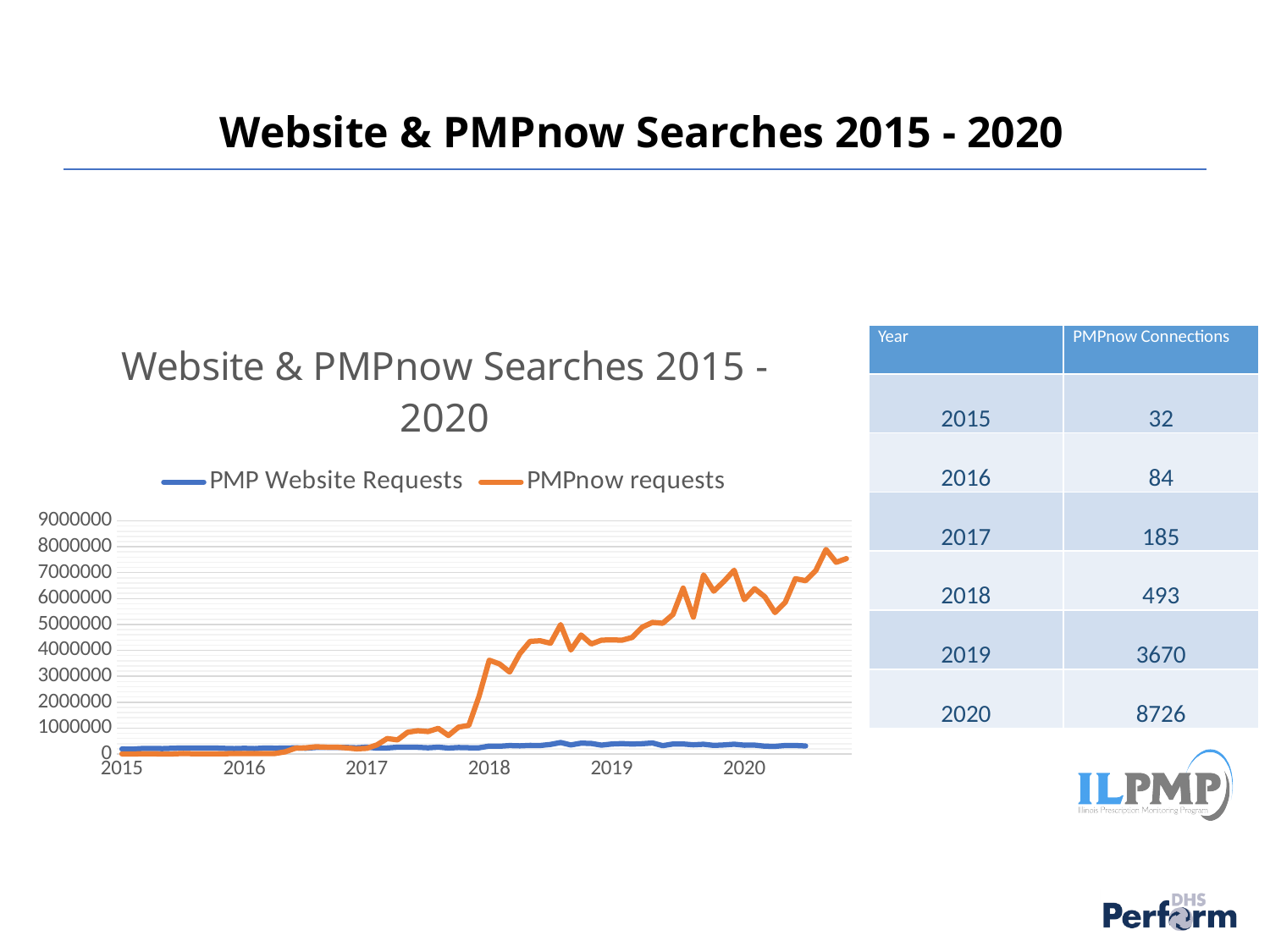
Which series has the higher values in 2020, PMP Website Requests or PMPnow requests? PMPnow requests Is the value for PMPnow requests at the end of 2020 greater or less than 7000000? greater Is the value for PMP Website Requests in 2019 greater or less than 1000000? less Is the value for PMPnow requests at the start of 2018 greater or less than 2000000? greater What is the highest value shown on the chart's y axis? 9000000 Do the PMPnow requests values generally rise or fall from 2015 to 2020? rise How many year labels are shown along the x axis of the chart? 6 How many series does the chart's legend list? 2 What kind of chart is shown on the slide? line chart What are the two series named in the chart's legend? PMP Website Requests and PMPnow requests What colour is the PMPnow requests line in the chart? orange